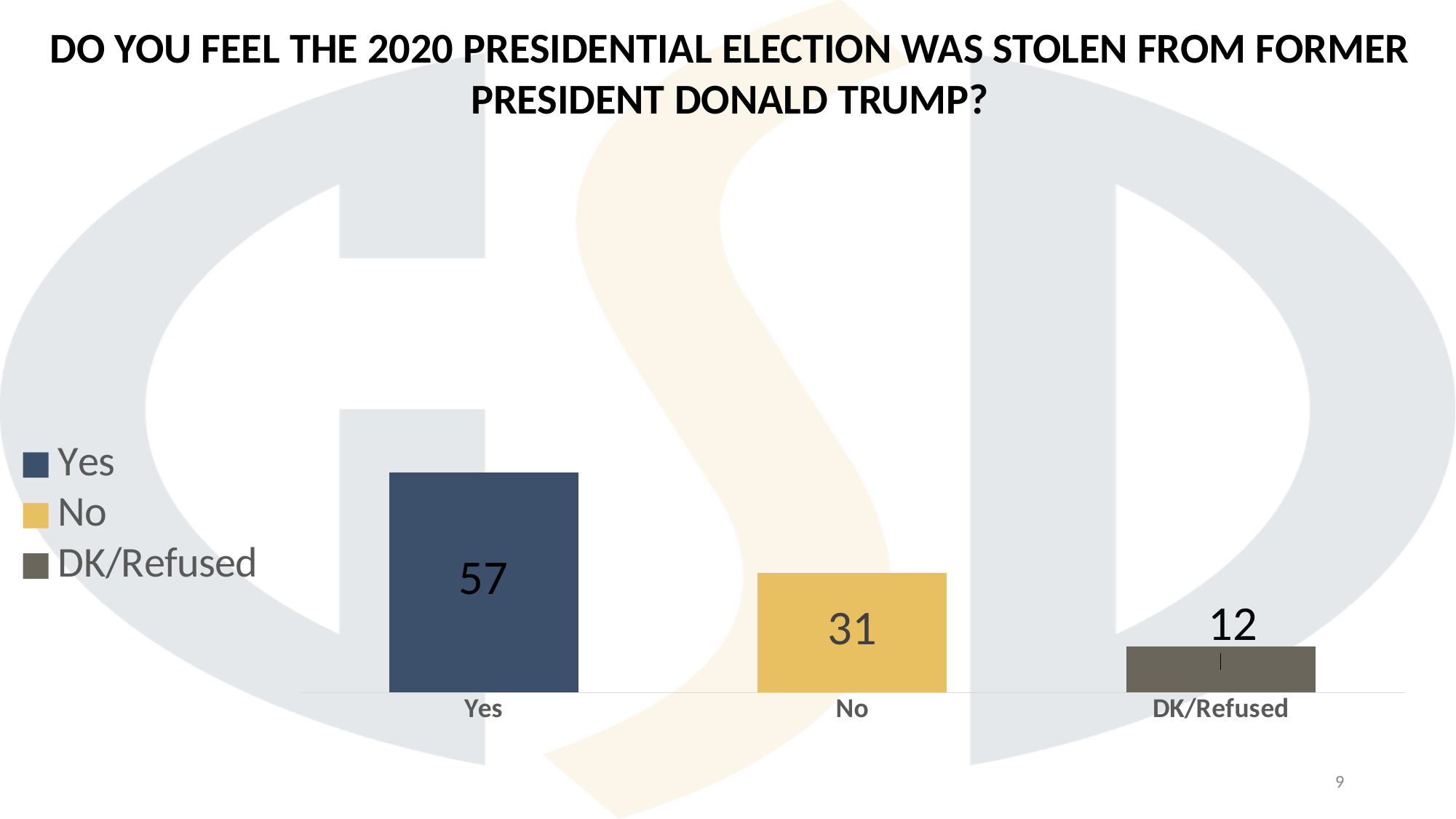
What is the value for Yes? 57 What is the value for DK/Refused? 12 What is the difference between the values for Yes and No? 26 Which category has the highest value? Yes What colour is the bar for No? Yellow Which category has the lowest value? DK/Refused What kind of chart is shown on the slide? Bar chart How many categories are shown on the x axis? 3 How many entries does the legend list? 3 Which is larger, the value for Yes or the value for No? Yes What is the value for No? 31 What is the difference between the values for No and DK/Refused? 19